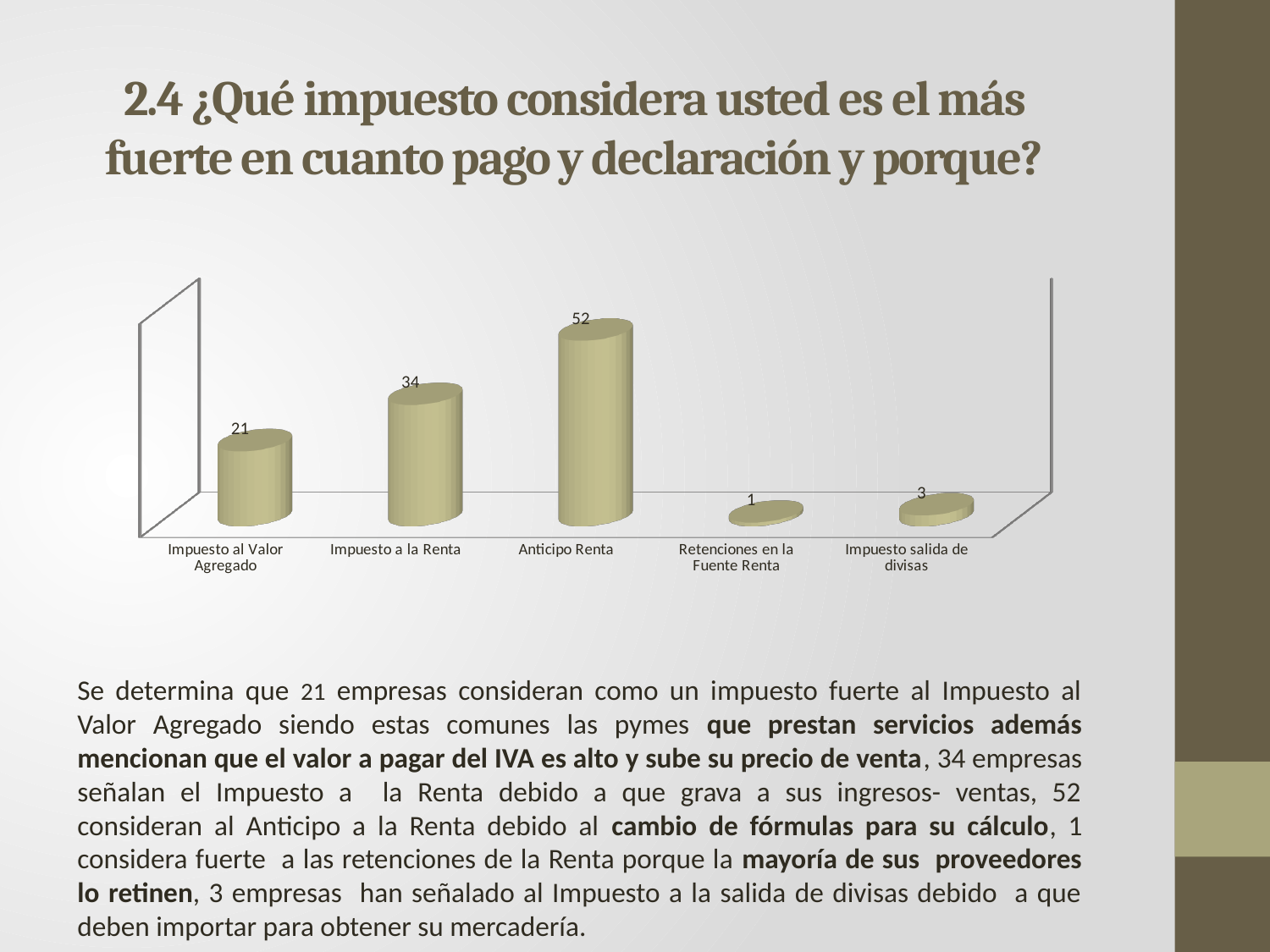
Which category has the lowest value? Retenciones en la Fuente Renta Which is larger, the value for Impuesto a la Renta or the value for Impuesto salida de divisas? Impuesto a la Renta What is the total of all the values shown in the chart? 111 What is the difference between the values for Impuesto a la Renta and Impuesto al Valor Agregado? 13 What kind of chart is shown on the slide? bar chart What is the value for Retenciones en la Fuente Renta? 1 Which category has the highest value? Anticipo Renta What is the value for Impuesto al Valor Agregado? 21 What is the value for Impuesto salida de divisas? 3 How many categories are shown in the chart? 5 What is the difference between the values for Anticipo Renta and Impuesto a la Renta? 18 What is the value for Anticipo Renta? 52